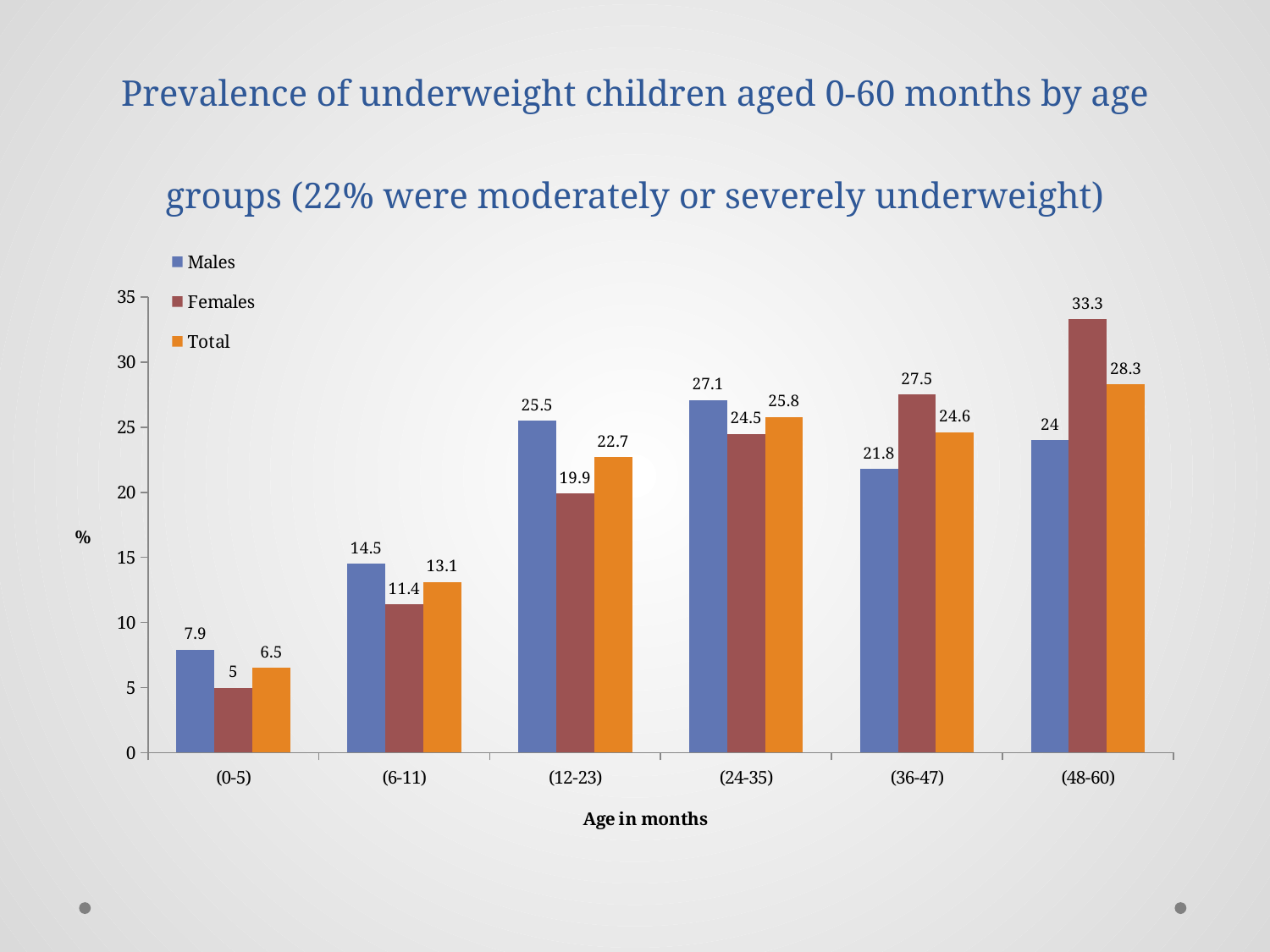
What is the Total value for the (6-11) age group? 13.1 What kind of chart is shown on the slide? Bar chart How many age groups are shown on the x axis? 6 What is the label of the x axis? Age in months What is the value for Females in the (48-60) age group? 33.3 In the (24-35) age group, which is larger, the Males value or the Females value? Males Which age group has the highest Total value? (48-60) What is the value for Males in the (12-23) age group? 25.5 How many series does the legend list? 3 Which age group has the lowest value for Females? (0-5) What is the difference between the Females and Males values in the (48-60) age group? 9.3 Do the Total values rise or fall from the (0-5) age group to the (48-60) age group? Rise